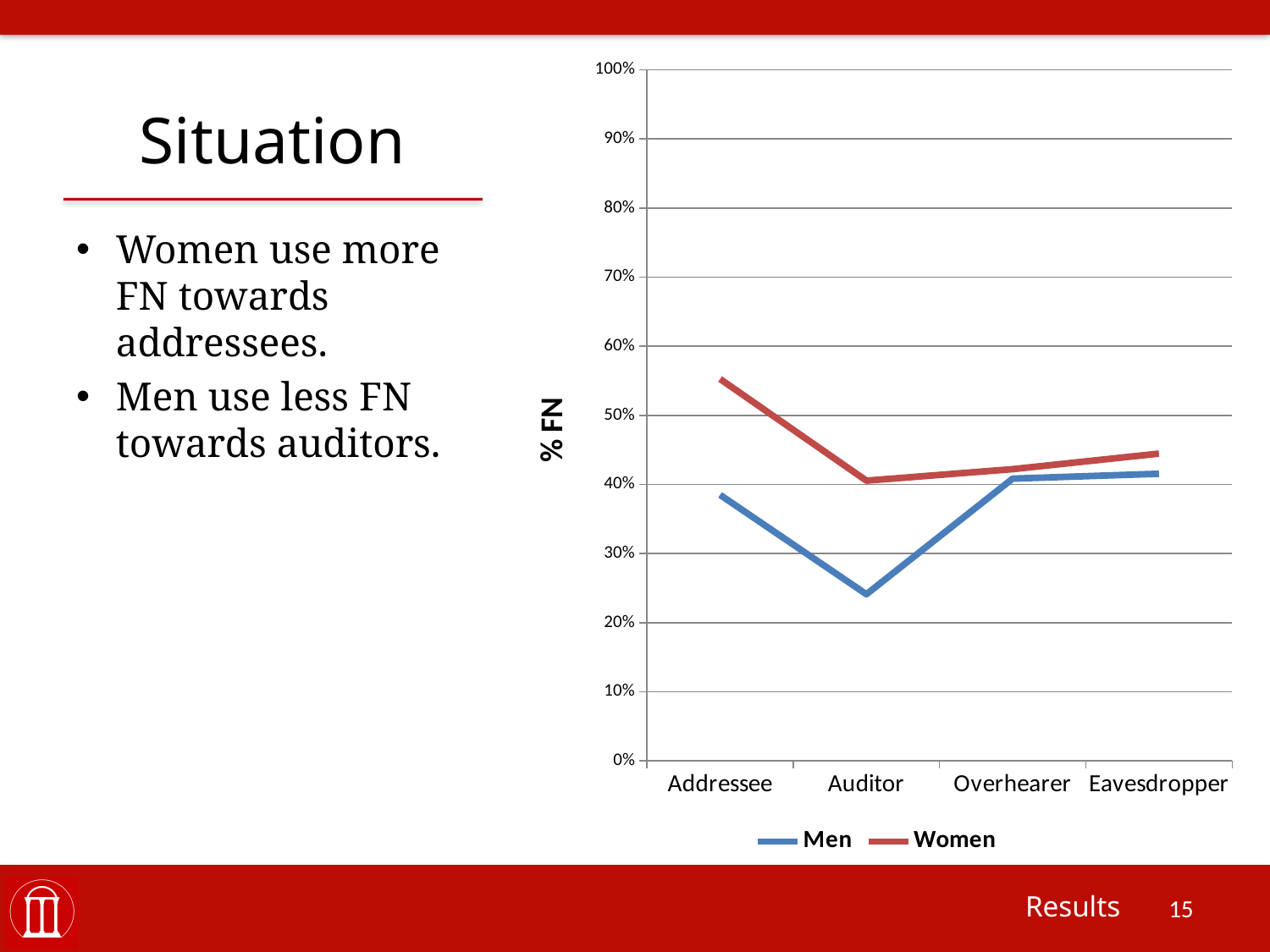
For which category is the Men series lowest? Auditor For which category is the Women series highest? Addressee Is the value for Men at Auditor greater or less than 30%? less What kind of chart is shown on the slide? line chart Is the value for Women at Addressee greater or less than 50%? greater At Addressee, which series has the higher value, Men or Women? Women How many categories are shown on the x axis? 4 Which series is drawn in red? Women How many series does the legend list? 2 What is the title of the vertical axis? % FN Does the Men series rise or fall from Addressee to Auditor? fall